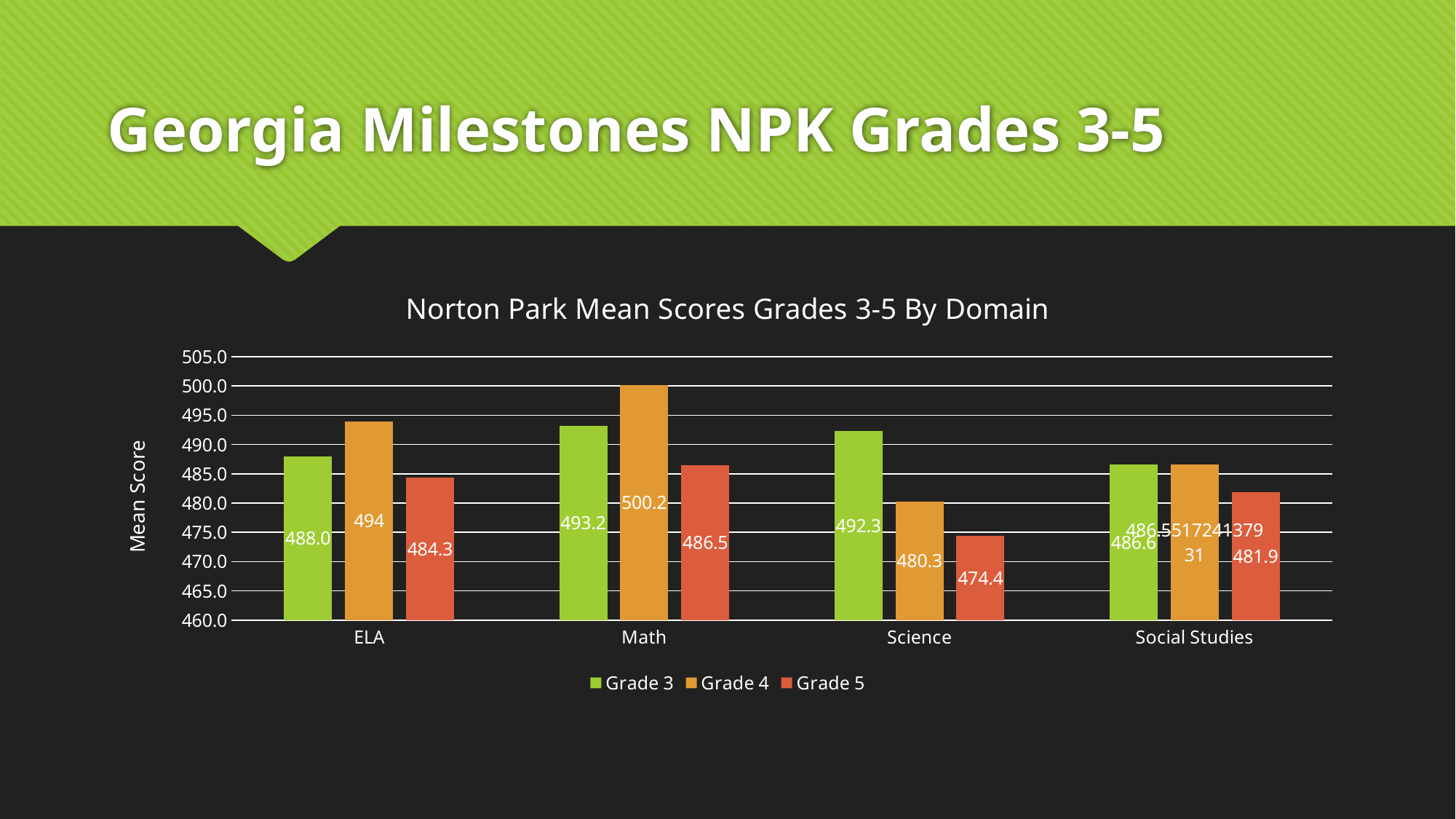
What is the Grade 3 mean score for Math? 493.2 What is the Grade 4 mean score for ELA? 494 What kind of chart is shown on the slide? bar chart Is the Grade 4 mean score for Science greater or less than 485? less How many domains are shown on the x axis? 4 What is the Grade 5 mean score for Social Studies? 481.9 Which domain has the highest Grade 4 mean score? Math What is the difference between the Grade 4 and Grade 5 mean scores for Math? 13.7 Which domain has the lowest Grade 5 mean score? Science For Science, which is higher: the Grade 3 or the Grade 4 mean score? Grade 3 How many series does the legend list? 3 What is the Grade 5 mean score for Science? 474.4